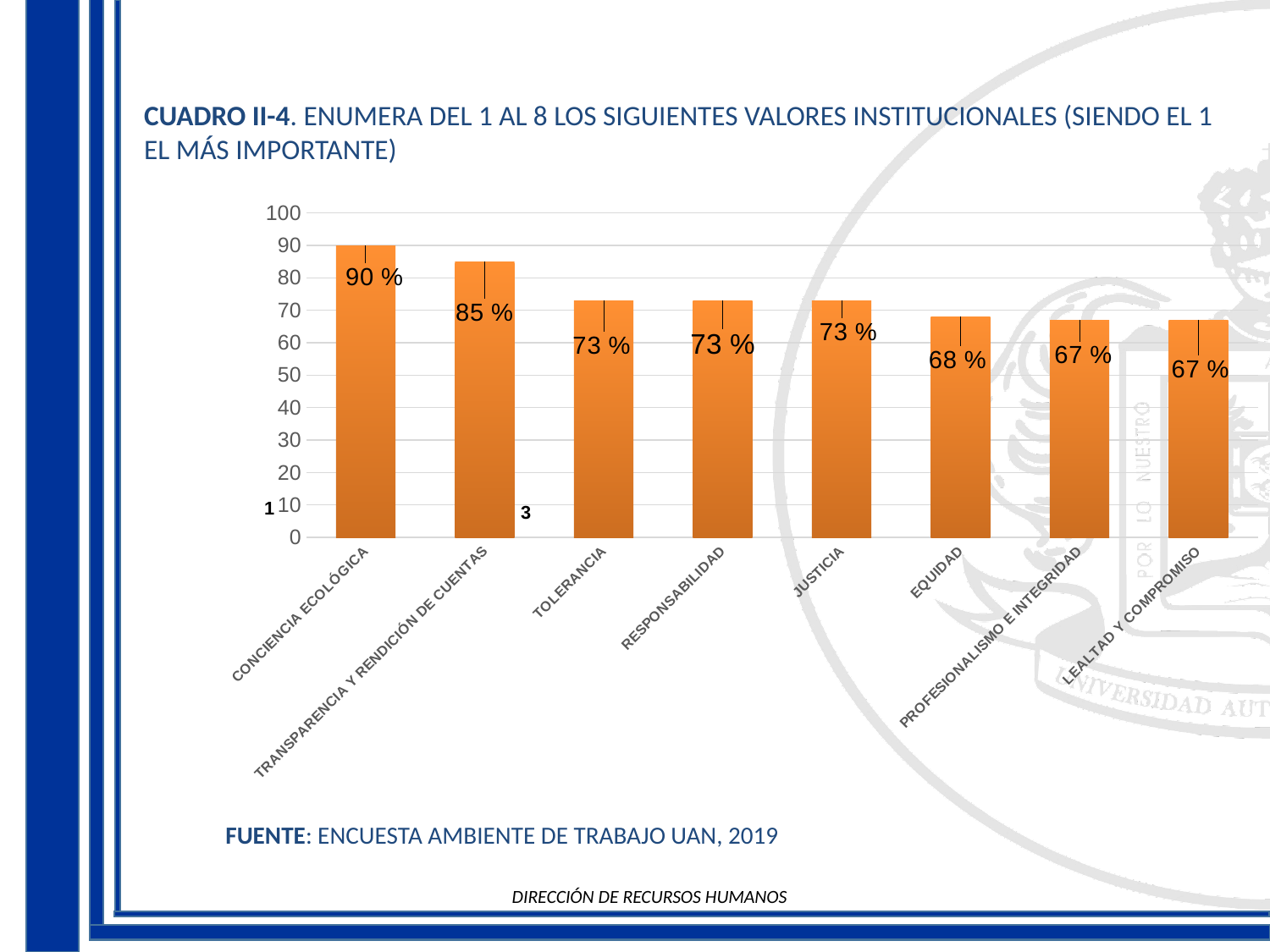
Do the values generally rise or fall from left to right along the x axis? fall How many categories are shown on the x axis? 8 What is the difference between the values for TOLERANCIA and LEALTAD Y COMPROMISO? 6 % Which is larger, the value for TRANSPARENCIA Y RENDICIÓN DE CUENTAS or the value for EQUIDAD? TRANSPARENCIA Y RENDICIÓN DE CUENTAS Is the value for PROFESIONALISMO E INTEGRIDAD greater or less than 80? less What is the value for CONCIENCIA ECOLÓGICA? 90 % What kind of chart is shown on the slide? bar chart Which category has the highest value? CONCIENCIA ECOLÓGICA What is the value for EQUIDAD? 68 % What is the difference between the values for CONCIENCIA ECOLÓGICA and TRANSPARENCIA Y RENDICIÓN DE CUENTAS? 5 % What is the value for TRANSPARENCIA Y RENDICIÓN DE CUENTAS? 85 % What is the value for JUSTICIA? 73 %